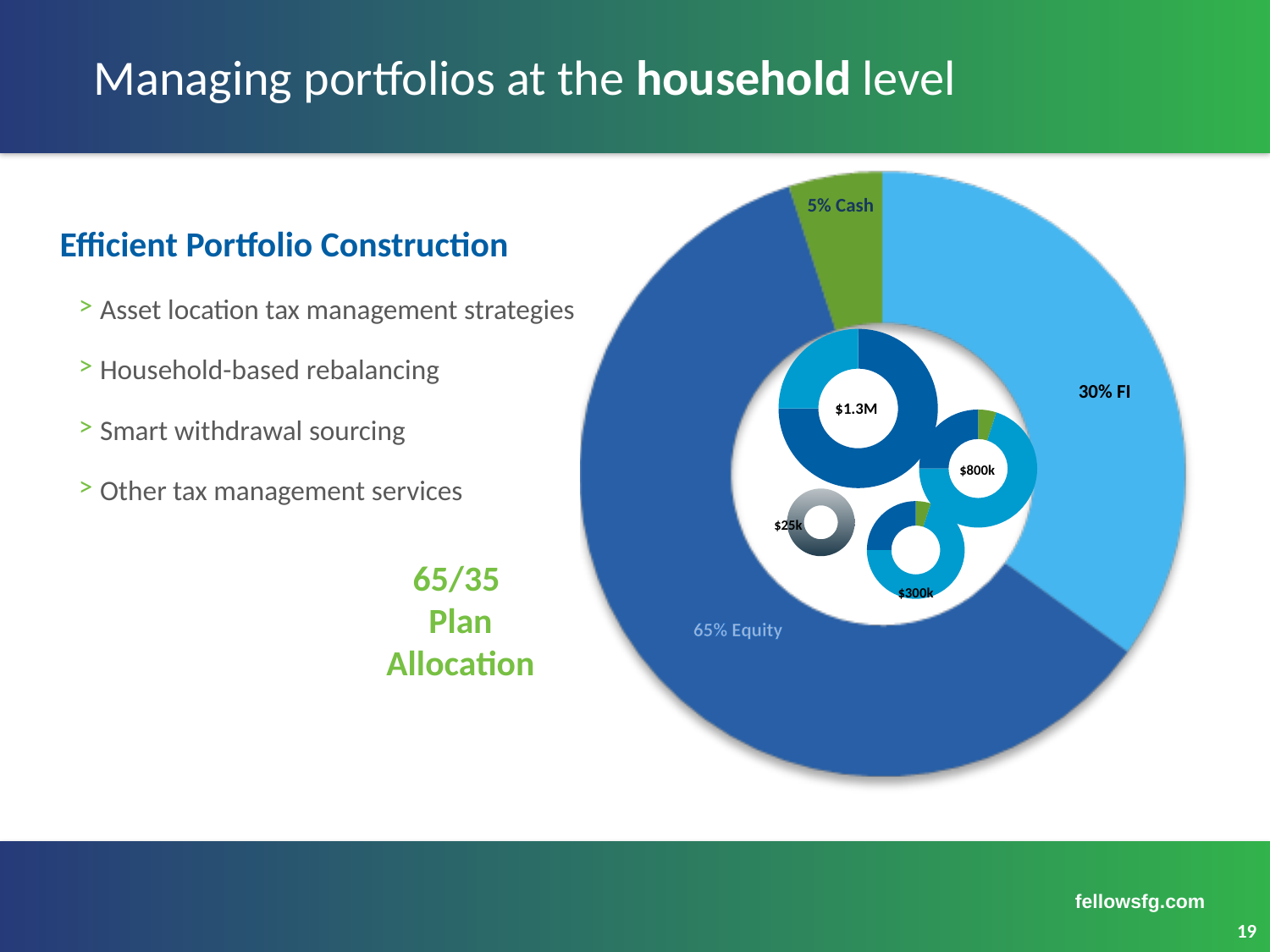
In the large donut chart, what percentage is labelled for Equity? 65% What is the green text label describing the large donut chart's allocation? 65/35 Plan Allocation In the large donut chart, how many percentage points larger is the Equity slice than the FI slice? 35 percentage points How many smaller donut charts are shown inside the large donut chart? 4 Which slice of the large donut chart is the smallest? Cash In the large donut chart, what percentage is labelled for Cash? 5% What kind of chart is the large chart on the right of the slide? Pie (donut) chart How many slices does the large donut chart have? 3 What share of the large donut chart does the Cash slice represent? 5% In the large donut chart, which is larger, the FI slice or the Cash slice? FI Which slice of the large donut chart is the largest? Equity In the large donut chart, what percentage is labelled for FI? 30%